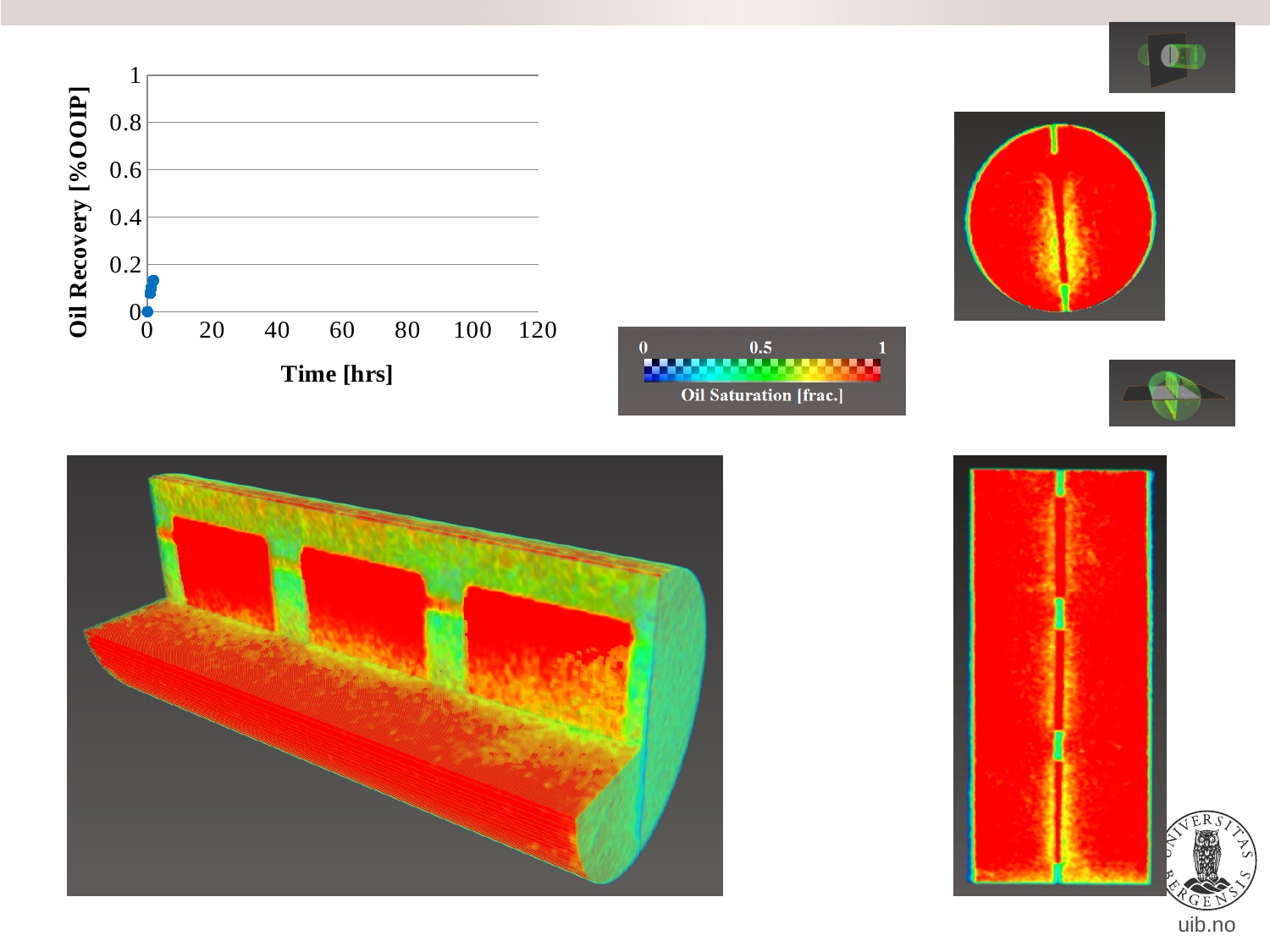
What is the title of the y axis of the chart? Oil Recovery [%OOIP] What kind of chart is shown on the slide? scatter chart Are the plotted points located at times greater or less than 20 hrs? less What is the highest value shown on the x axis of the chart? 120 What is the highest value shown on the y axis of the chart? 1 Are the plotted oil recovery values greater or less than 0.2? less